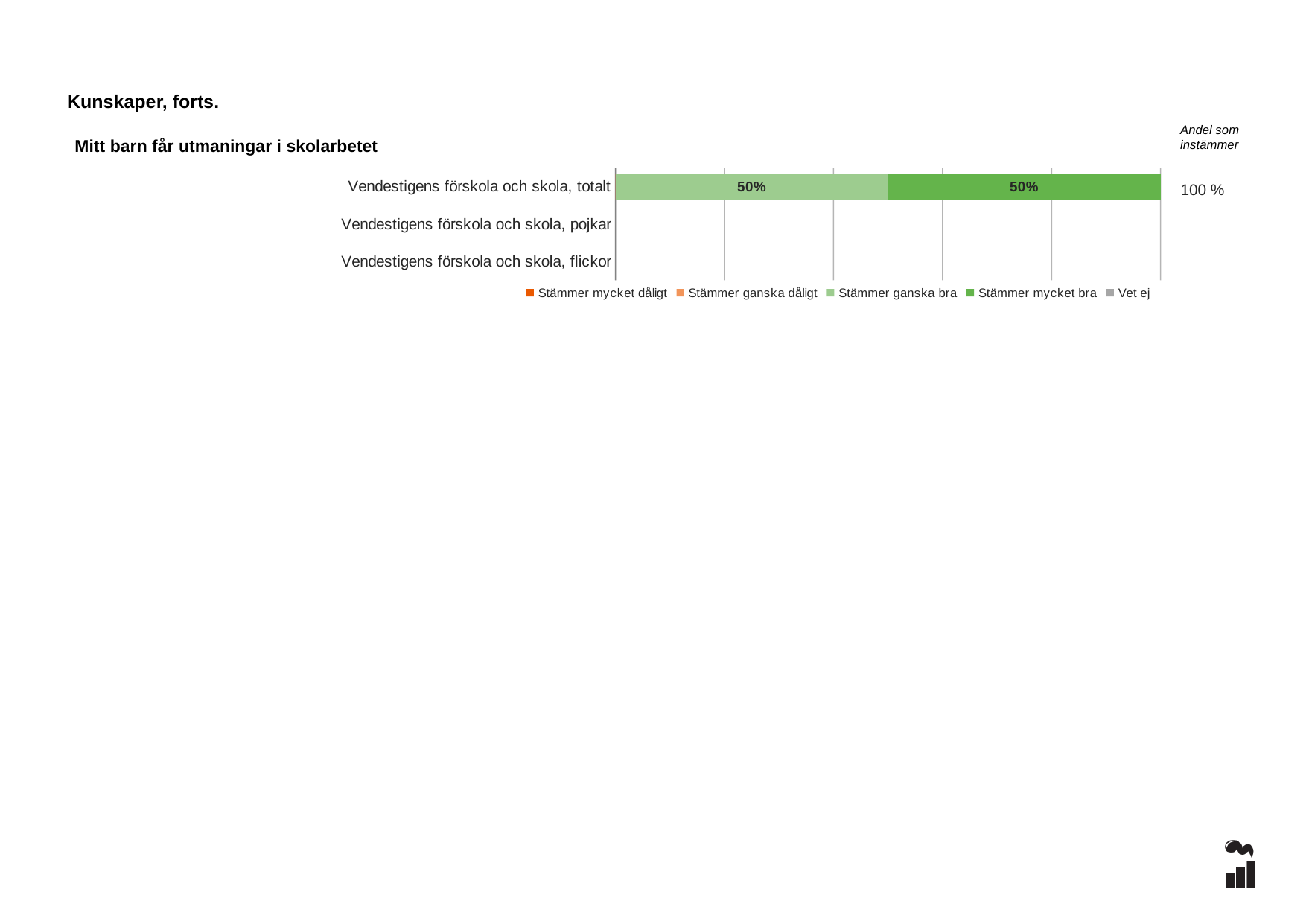
What is the value for 'Stämmer mycket bra' for Vendestigens förskola och skola, totalt? 50% How many series does the legend list? 5 What is the title of the chart? Mitt barn får utmaningar i skolarbetet What kind of chart is shown on the slide? bar chart Which legend entry is shown in the darkest green colour? Stämmer mycket bra What is the value for 'Stämmer ganska bra' for Vendestigens förskola och skola, totalt? 50% What is the total of the stacked bar for Vendestigens förskola och skola, totalt? 100% How many categories are listed on the vertical axis of the chart? 3 What is the 'Andel som instämmer' value shown for Vendestigens förskola och skola, totalt? 100 % What is the difference between the 'Stämmer ganska bra' and 'Stämmer mycket bra' values for Vendestigens förskola och skola, totalt? 0% Which category has the highest total bar value? Vendestigens förskola och skola, totalt